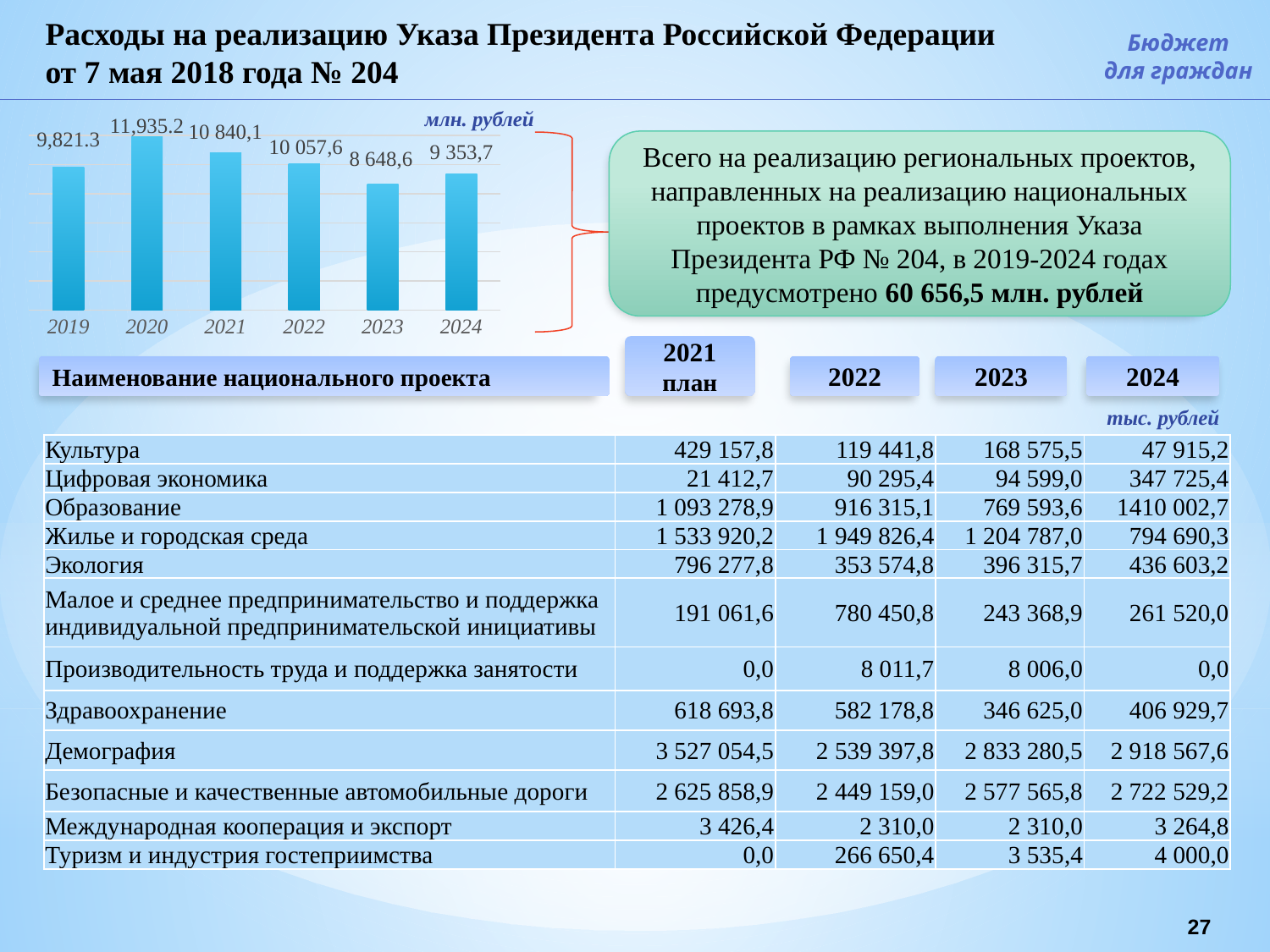
In the bar chart, what is the difference between the values for 2021 and 2022? 782,5 What is the value shown for 2019 in the bar chart? 9,821.3 How many years are shown in the bar chart? 6 Which year has the highest value in the bar chart? 2020 In the bar chart, what is the difference between the values for 2024 and 2023? 705,1 What is the value shown for 2024 in the bar chart? 9 353,7 Which year has the lowest value in the bar chart? 2023 What type of chart is shown on the slide? bar chart Do the values in the bar chart rise or fall from 2020 to 2023? fall What is the value shown for 2022 in the bar chart? 10 057,6 What unit is indicated above the bar chart? млн. рублей In the bar chart, which year has the larger value, 2021 or 2024? 2021